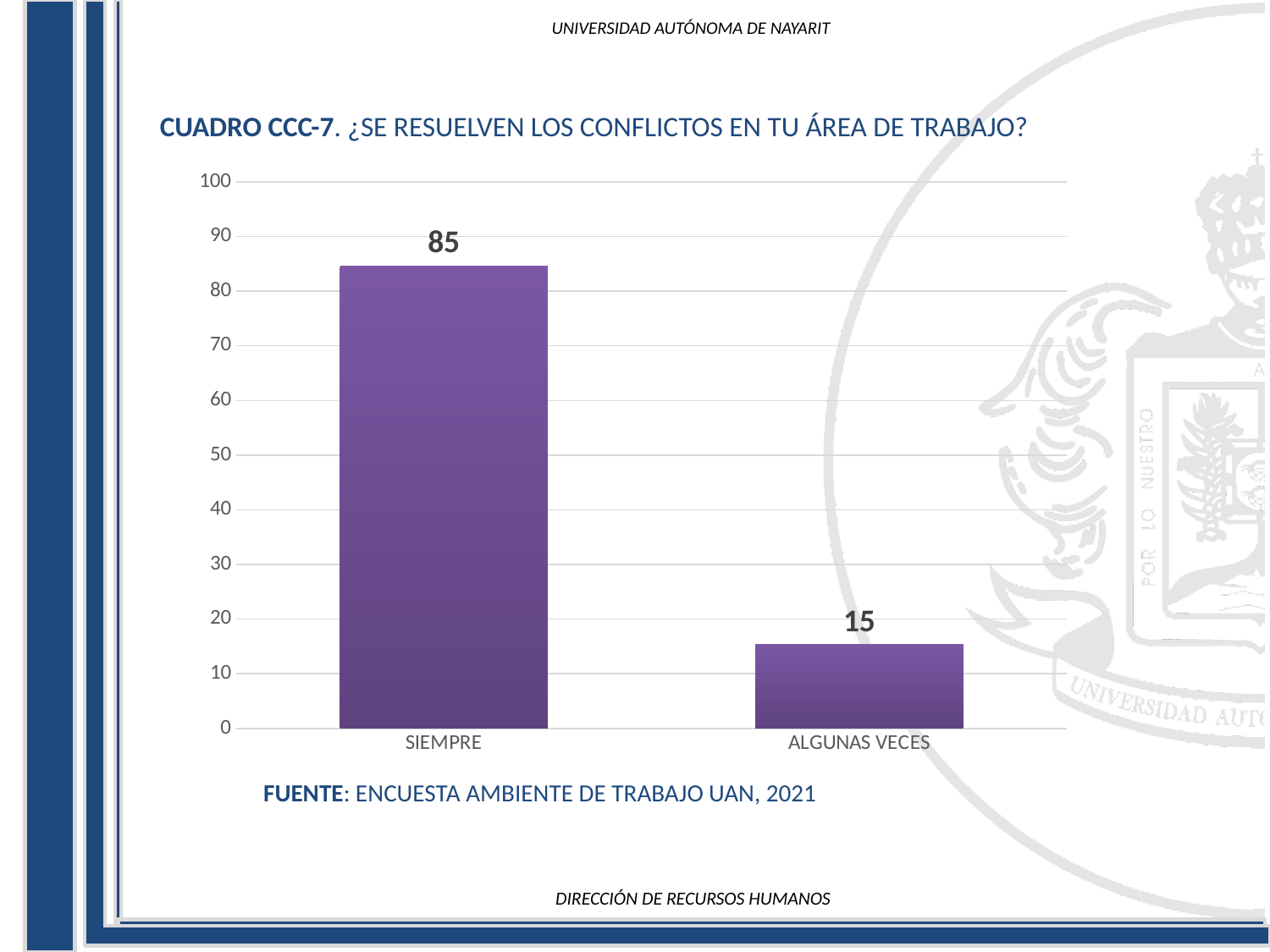
What is the value for ALGUNAS VECES? 15 What is the source cited below the chart? ENCUESTA AMBIENTE DE TRABAJO UAN, 2021 Is the value for SIEMPRE greater or less than 50? greater What is the total of the two values shown in the chart? 100 What is the value for SIEMPRE? 85 Is the value for ALGUNAS VECES greater or less than 20? less What kind of chart is shown on the slide? bar chart What is the difference between the values for SIEMPRE and ALGUNAS VECES? 70 Which category has the lowest value? ALGUNAS VECES Which category has the highest value? SIEMPRE Which is larger, the value for SIEMPRE or the value for ALGUNAS VECES? SIEMPRE How many categories are shown on the x axis? 2